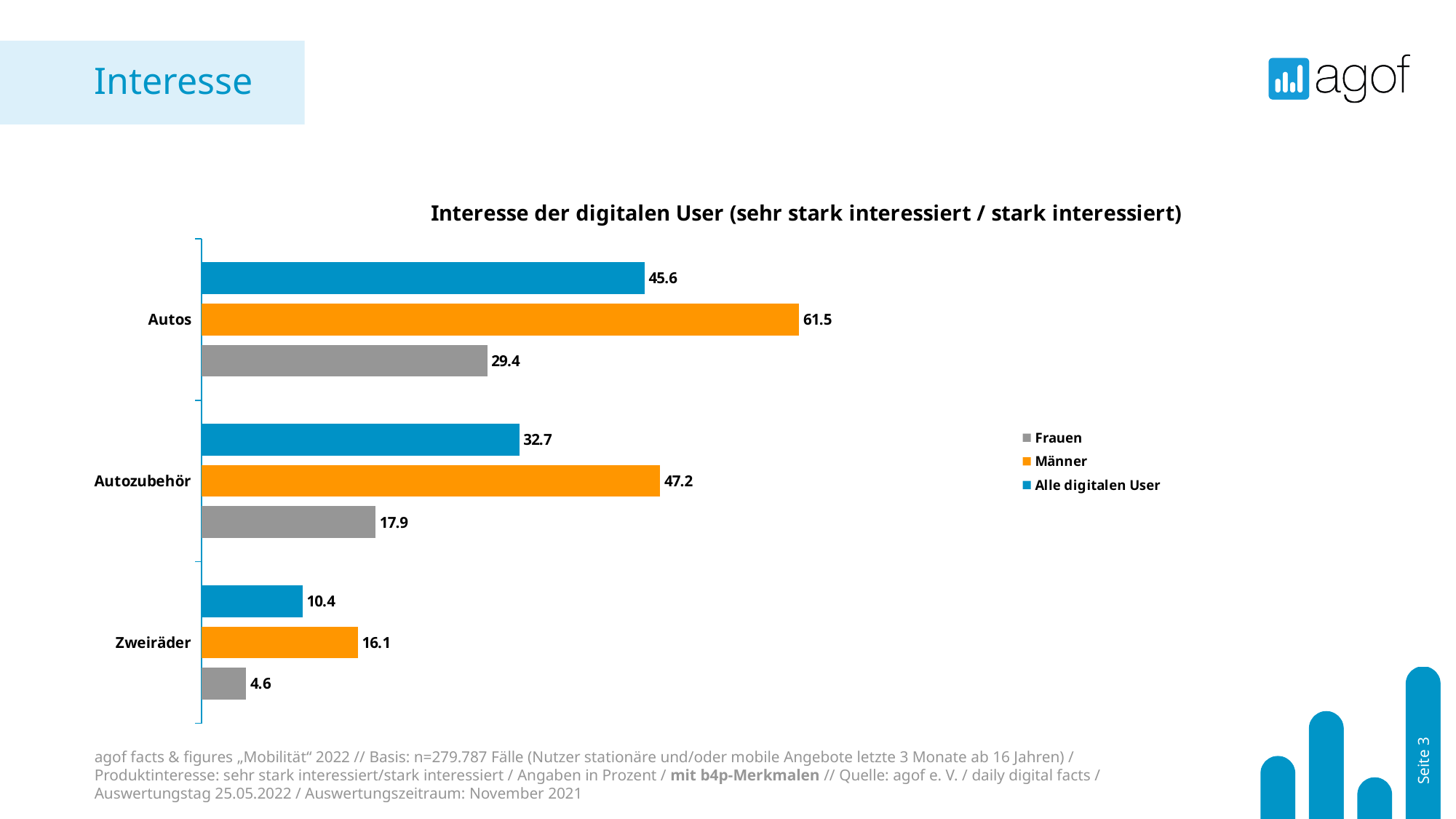
What is the value for Männer in the Autos category? 61.5 What is the value for Frauen in the Autozubehör category? 17.9 What is the difference between the Männer and Frauen values for Autos? 32.1 What is the value for Alle digitalen User in the Zweiräder category? 10.4 Which category has the highest value for Männer? Autos How many series does the legend list? 3 How many categories are shown on the chart? 3 Which category has the lowest value for Frauen? Zweiräder Which series is shown in orange? Männer Which is larger: the Männer value for Autozubehör or the Alle digitalen User value for Autos? Männer value for Autozubehör What kind of chart is shown on the slide? Bar chart What is the difference between the Alle digitalen User values for Autos and Autozubehör? 12.9